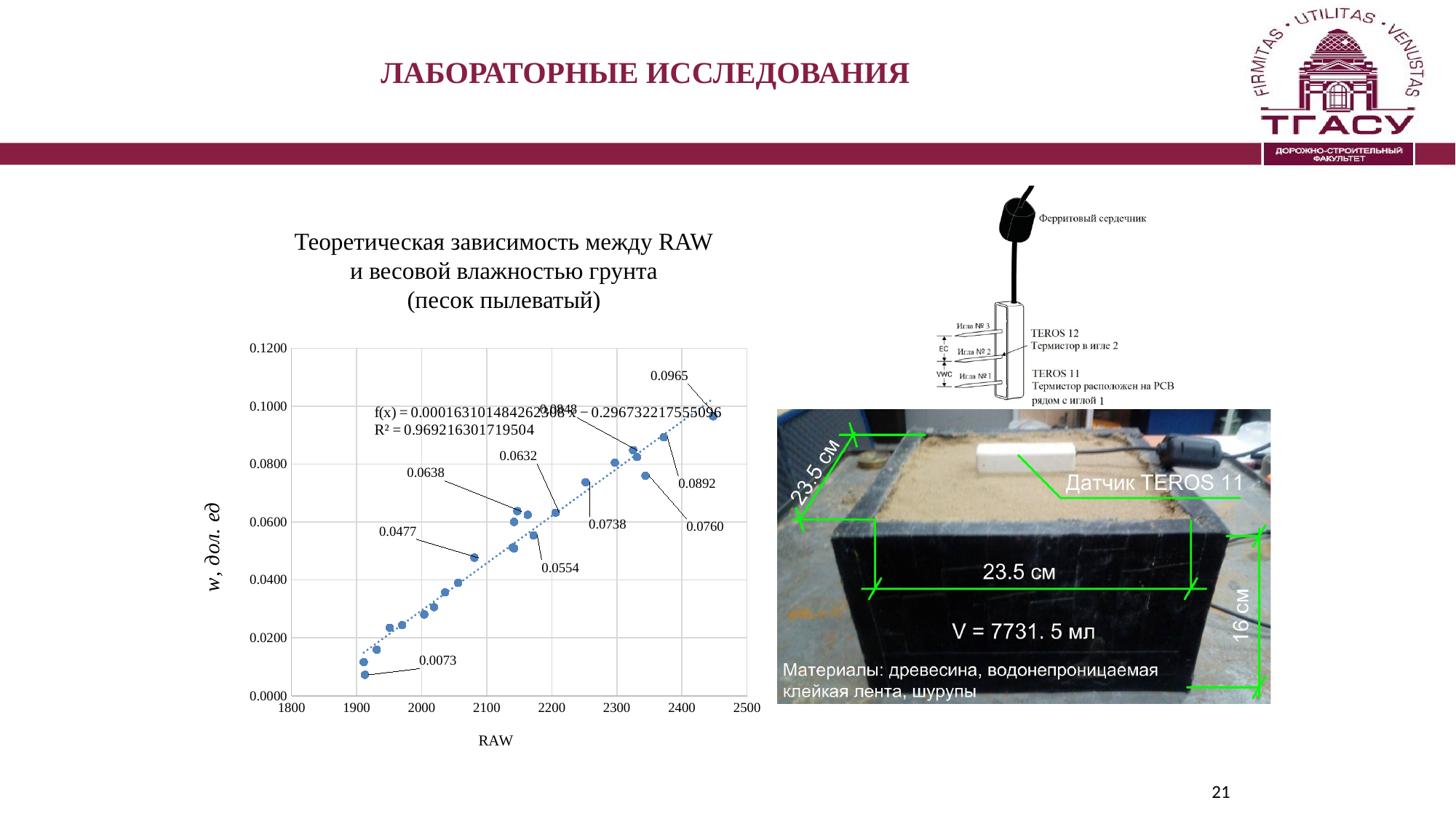
How many data labels are printed on the chart? 10 What kind of chart is shown on the slide? scatter chart What R² value is printed on the chart? R² = 0.969216301719504 What is the difference between the highest labeled value (0.0965) and the lowest labeled value (0.0073)? 0.0892 Which is larger, the labeled value 0.0638 or the labeled value 0.0554? 0.0638 What is the label of the x axis of the chart? RAW Is the value of the point near RAW 2450 greater or less than 0.0800? greater Do the plotted values rise or fall as RAW increases along the x axis? rise What is the title of the chart? Теоретическая зависимость между RAW и весовой влажностью грунта (песок пылеватый) Is the value of the point at RAW 2000 greater or less than 0.0400? less What is the lowest data label printed on the chart? 0.0073 What is the highest data label printed on the chart? 0.0965